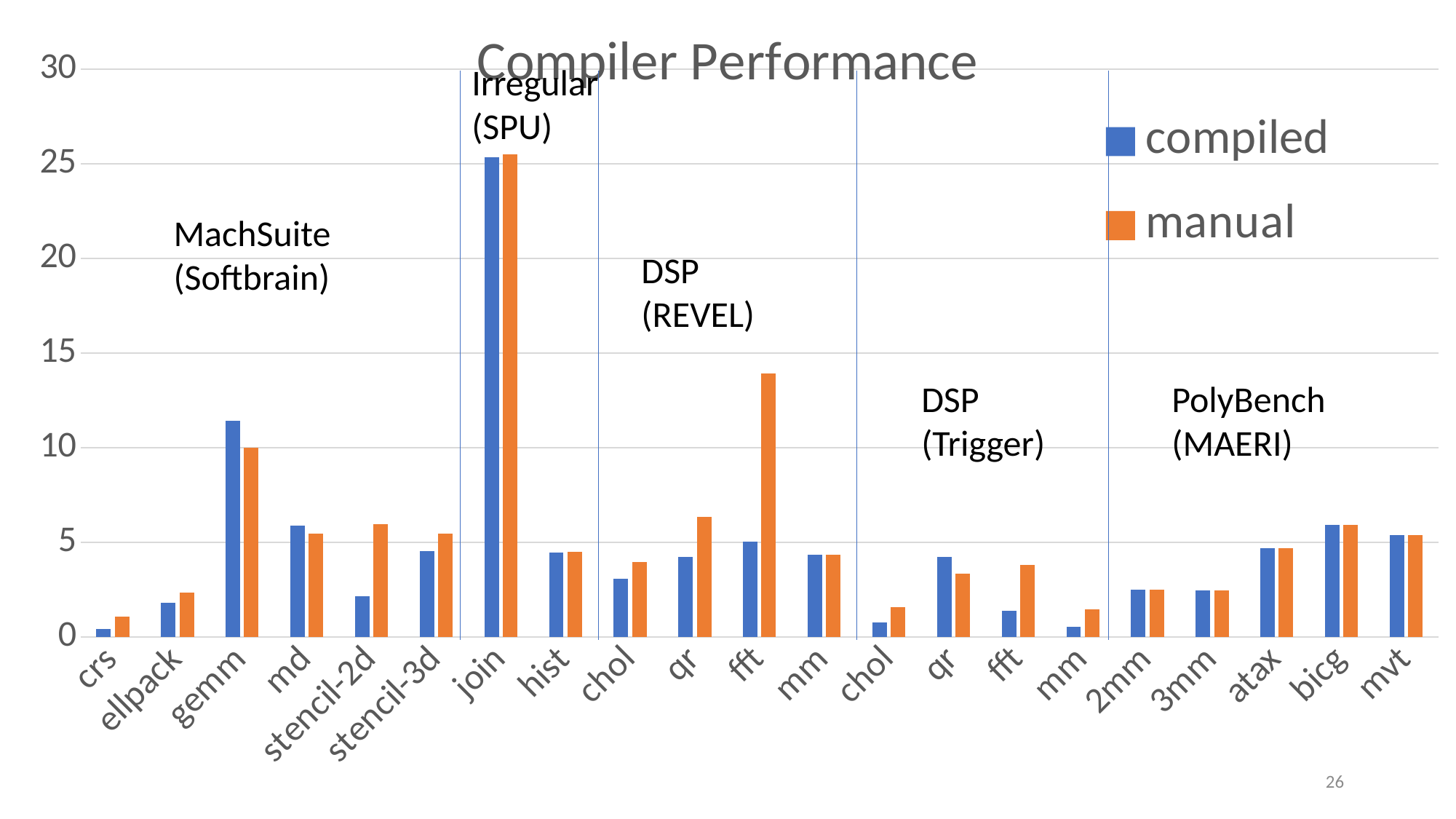
What kind of chart is shown on the slide? bar chart Which category has the highest manual value? join Is the compiled value for stencil-2d greater or less than 5? less Is the manual value for fft in the DSP (REVEL) group greater or less than 10? greater How many category labels are shown along the x axis? 21 What are the two series named in the legend? compiled and manual For fft in the DSP (REVEL) group, which is larger, the compiled value or the manual value? manual Is the compiled value for join greater or less than 20? greater What is the title of the chart? Compiler Performance How many series does the legend list? 2 Which category has the highest compiled value? join